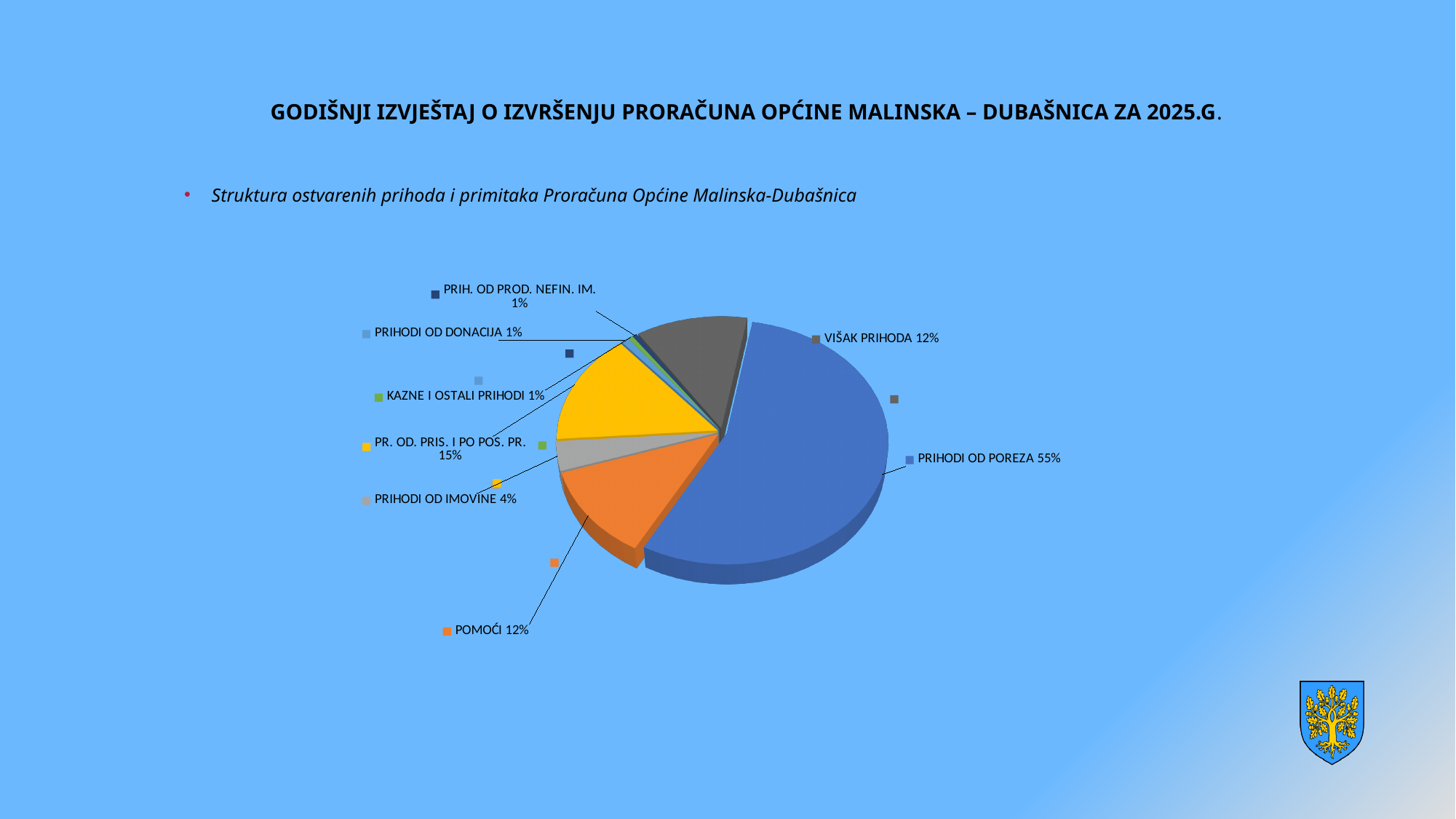
What kind of chart is shown on the slide? Pie chart What share of the pie does PRIHODI OD POREZA represent? 55% What is the value shown for PR. OD. PRIS. I PO POS. PR.? 15% What percentage is shown for VIŠAK PRIHODA? 12% What is the difference between the shares of PR. OD. PRIS. I PO POS. PR. and VIŠAK PRIHODA? 3% How many slices does the pie chart have? 8 What is the difference between the shares of PRIHODI OD POREZA and PR. OD. PRIS. I PO POS. PR.? 40% What percentage is shown for PRIHODI OD IMOVINE? 4% Which category has the largest slice of the pie? PRIHODI OD POREZA Which is larger, the share for PRIHODI OD IMOVINE or the share for POMOĆI? POMOĆI What colour is the slice for PRIHODI OD POREZA? Blue What percentage is shown for POMOĆI? 12%